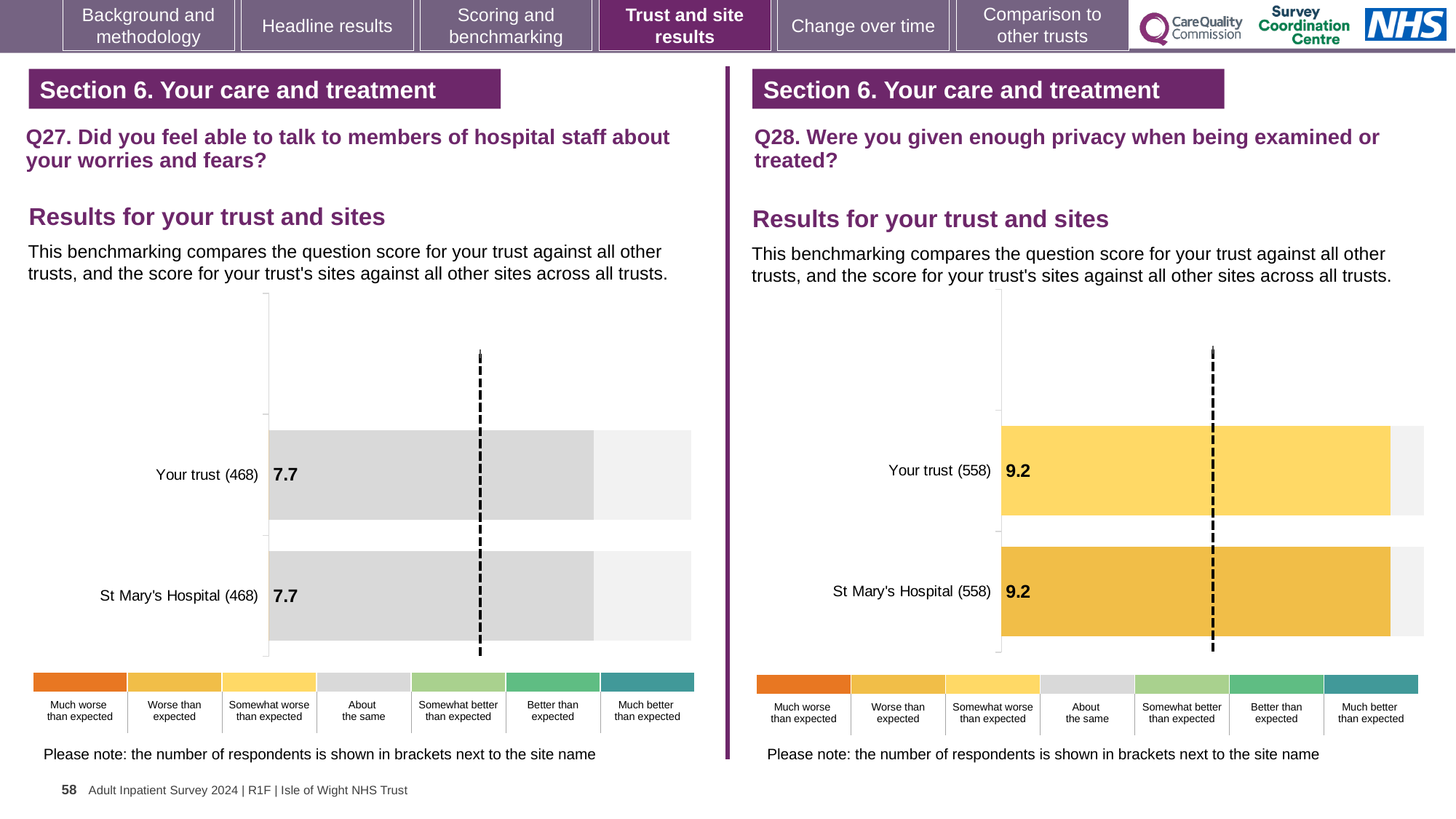
In the Q28 chart on the right, what is the score for Your trust? 9.2 In the Q27 chart on the left, how many bars are plotted? 2 In the Q27 chart on the left, how many respondents are shown in brackets for St Mary's Hospital? 468 In the Q28 chart on the right, which benchmark category does the colour of the Your trust bar correspond to in the key? Somewhat worse than expected In the Q28 chart on the right, how many respondents are shown in brackets for Your trust? 558 In the Q27 chart on the left, what is the difference between the score for Your trust and the score for St Mary's Hospital? 0.0 What kind of chart is the Q28 chart on the right? Bar chart In the Q28 chart on the right, what is the score for St Mary's Hospital? 9.2 In the Q28 chart on the right, how many bars are plotted? 2 In the Q27 chart on the left, what is the score for St Mary's Hospital? 7.7 How many categories does the colour key below the Q27 chart on the left list? 7 In the Q27 chart on the left, what is the score for Your trust? 7.7